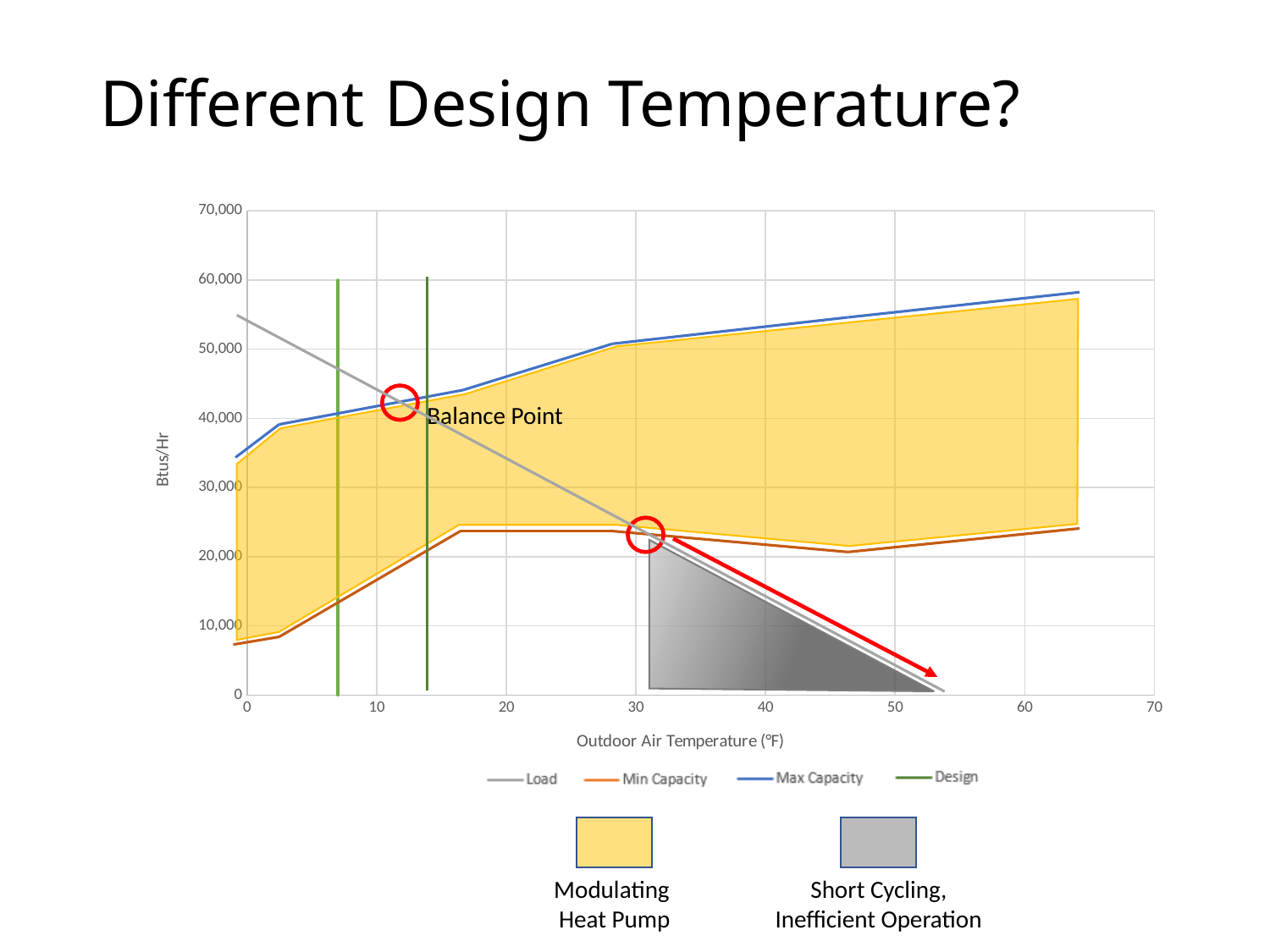
Is the Max Capacity value at 60°F greater or less than 50,000? greater What kind of chart is shown on the slide? line chart What is the title of the vertical axis? Btus/Hr Does the Load line rise or fall as outdoor air temperature increases? falls Is the Load value at 0°F greater or less than 50,000? greater How many series does the chart legend list? 4 Is the Min Capacity value at 0°F greater or less than 10,000? less At 0°F, which is larger: Load or Max Capacity? Load At 50°F, which is larger: Max Capacity or Load? Max Capacity Does the Max Capacity line rise or fall as outdoor air temperature increases? rises What label is written next to the circled intersection of the Load and Max Capacity lines? Balance Point